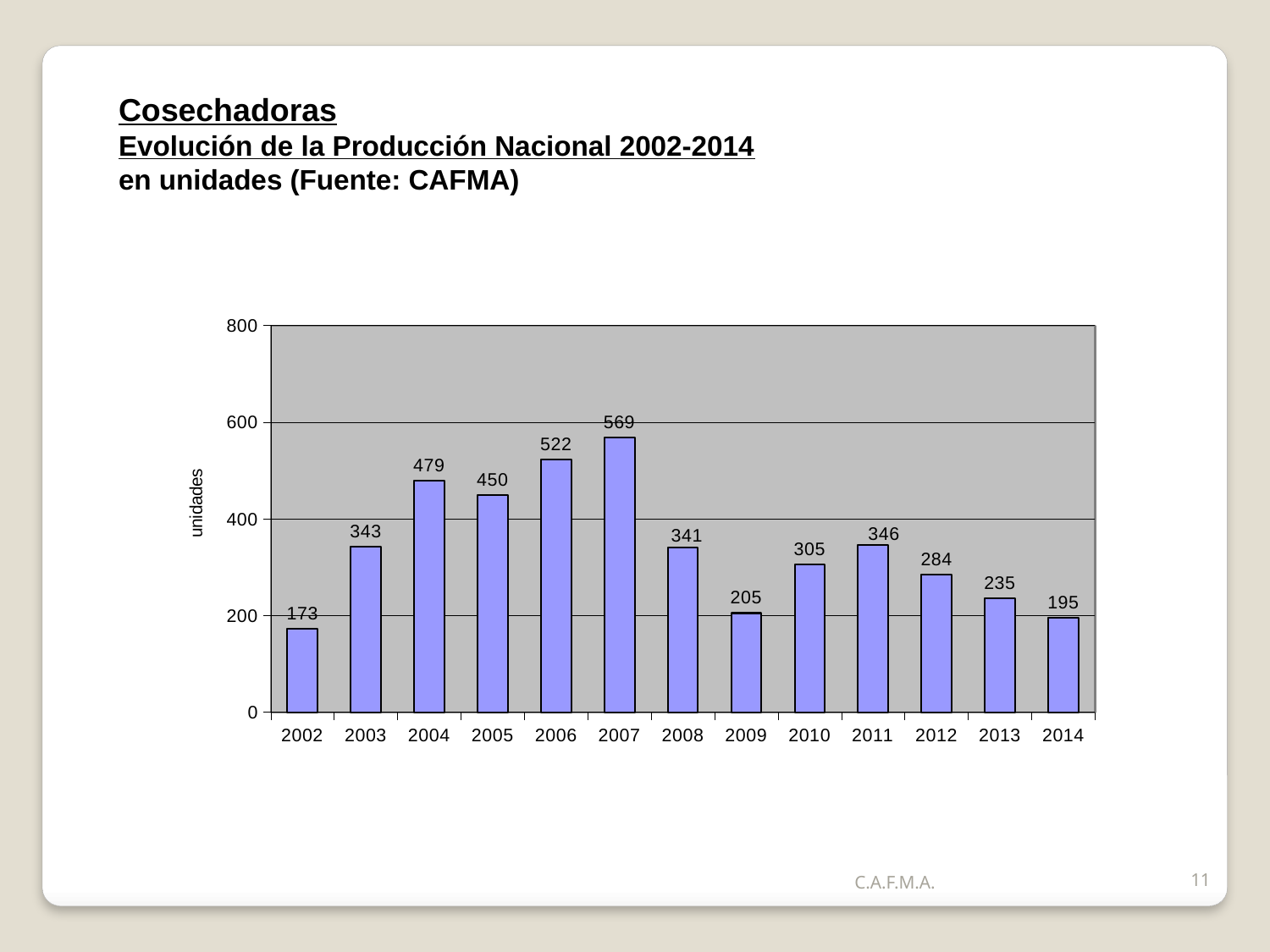
How many years are shown on the x axis? 13 Which year has the highest value? 2007 What is the label of the y axis? unidades What kind of chart is shown on the slide? bar chart What is the value for 2002? 173 Is the value for 2006 greater or less than 400? greater Which year has the lowest value? 2002 What is the value for 2007? 569 What is the difference between the values for 2007 and 2014? 374 What is the value for 2012? 284 What is the difference between the values for 2004 and 2005? 29 Which is larger, the value for 2010 or the value for 2011? 2011